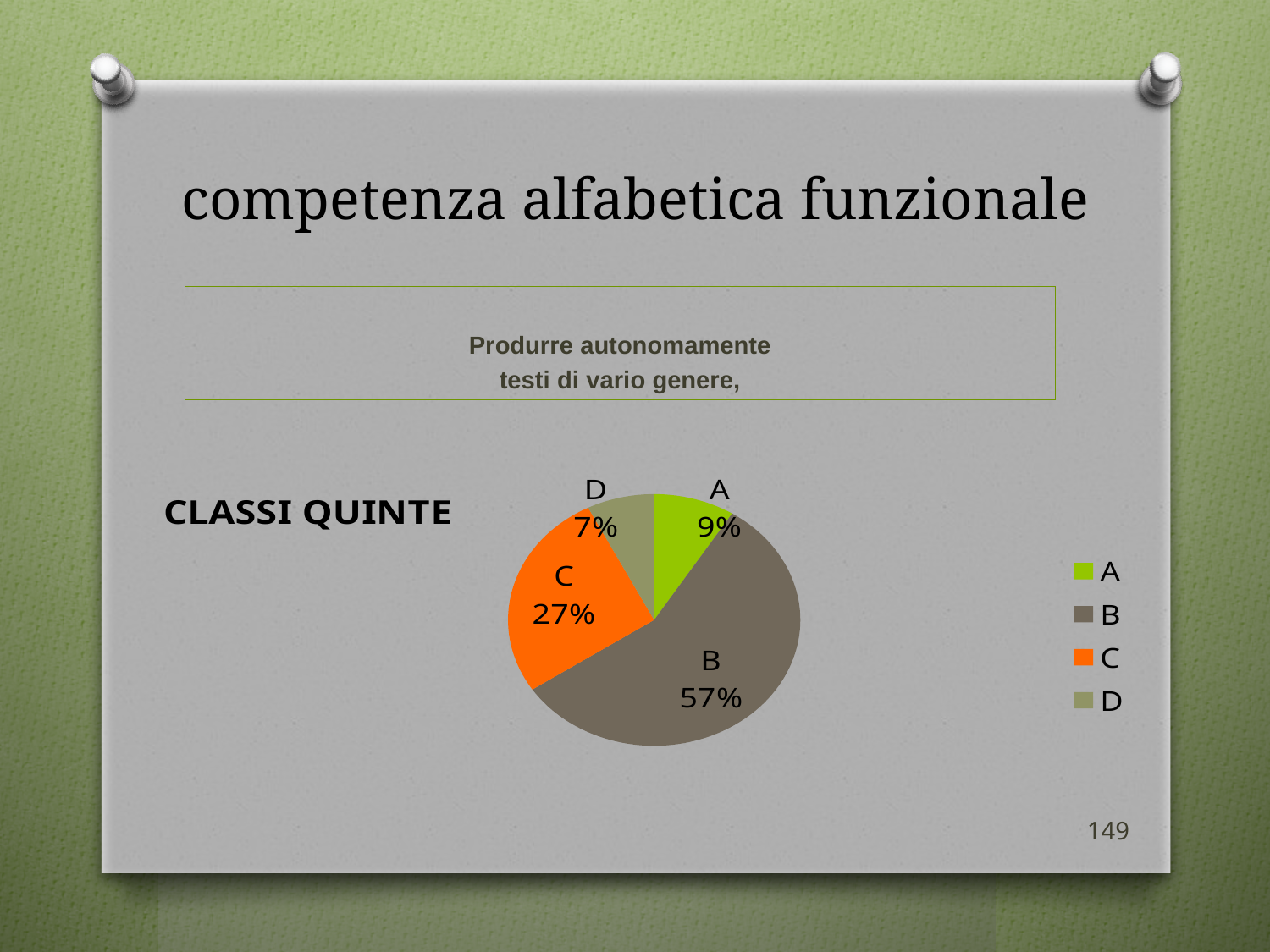
What colour is slice C in the pie chart? orange What share of the pie does slice D have? 7% Which slice of the pie is the largest? B What is the difference between the shares of B and C? 30% What share of the pie does slice B have? 57% What share of the pie does slice A have? 9% How many slices does the pie chart have? 4 Which slice of the pie is the smallest? D What kind of chart is shown on the slide? pie chart Which is larger, the share of A or the share of C? C How many entries does the legend list? 4